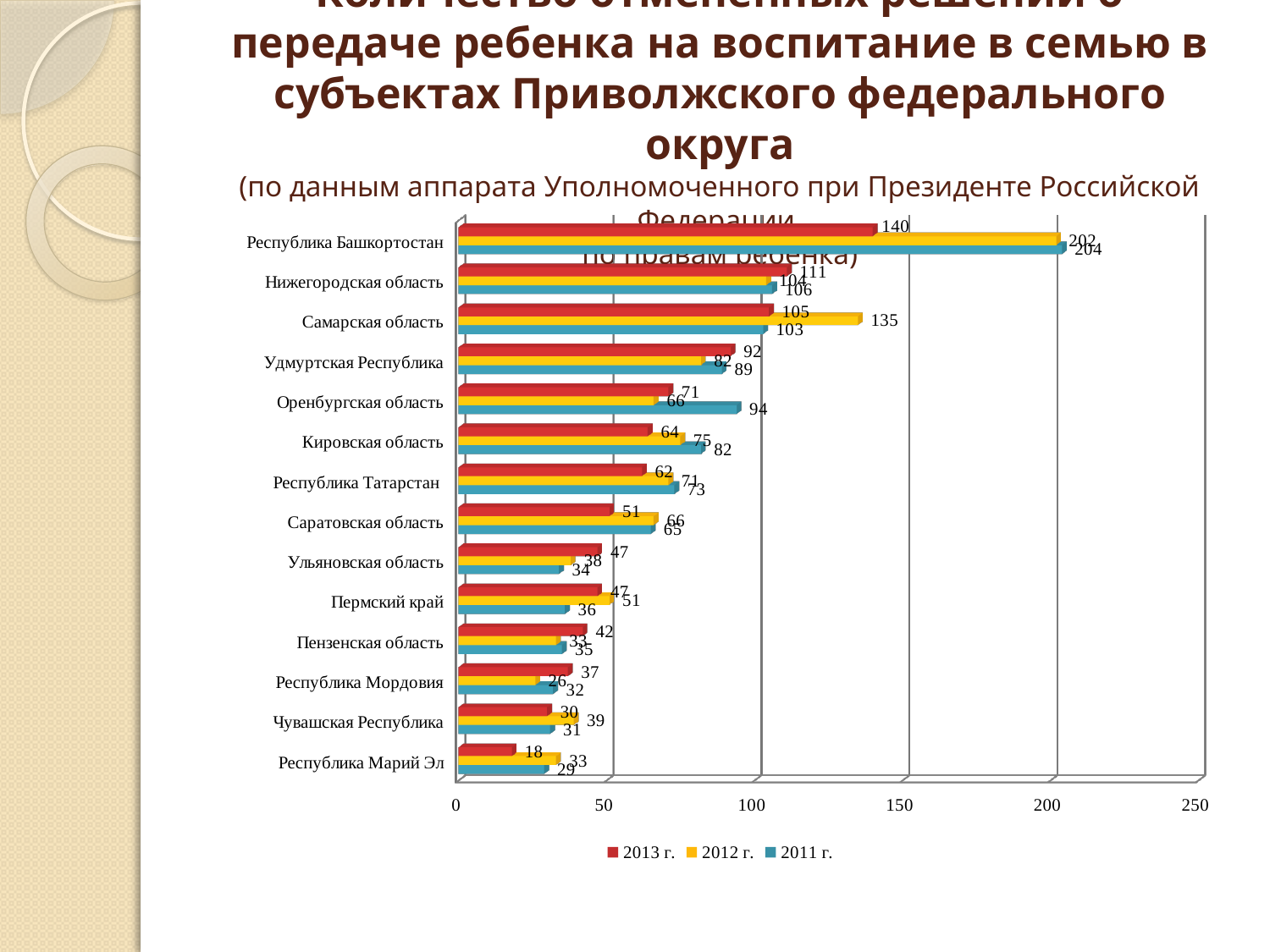
Is the 2012 г. value for Республика Башкортостан greater or less than 150? greater What kind of chart is shown on the slide? Bar chart What is the value for Республика Марий Эл in the 2013 г. series? 18 How many series does the legend list? 3 What is the difference between the 2012 г. and 2013 г. values for Самарская область? 30 Which category has the lowest value in the 2013 г. series? Республика Марий Эл What is the value for Самарская область in the 2012 г. series? 135 Which is larger for Кировская область: the 2011 г. value or the 2013 г. value? 2011 г. How many categories (regions) are shown on the chart? 14 What is the value for Республика Башкортостан in the 2013 г. series? 140 Which category has the highest value in the 2013 г. series? Республика Башкортостан What is the value for Оренбургская область in the 2011 г. series? 94